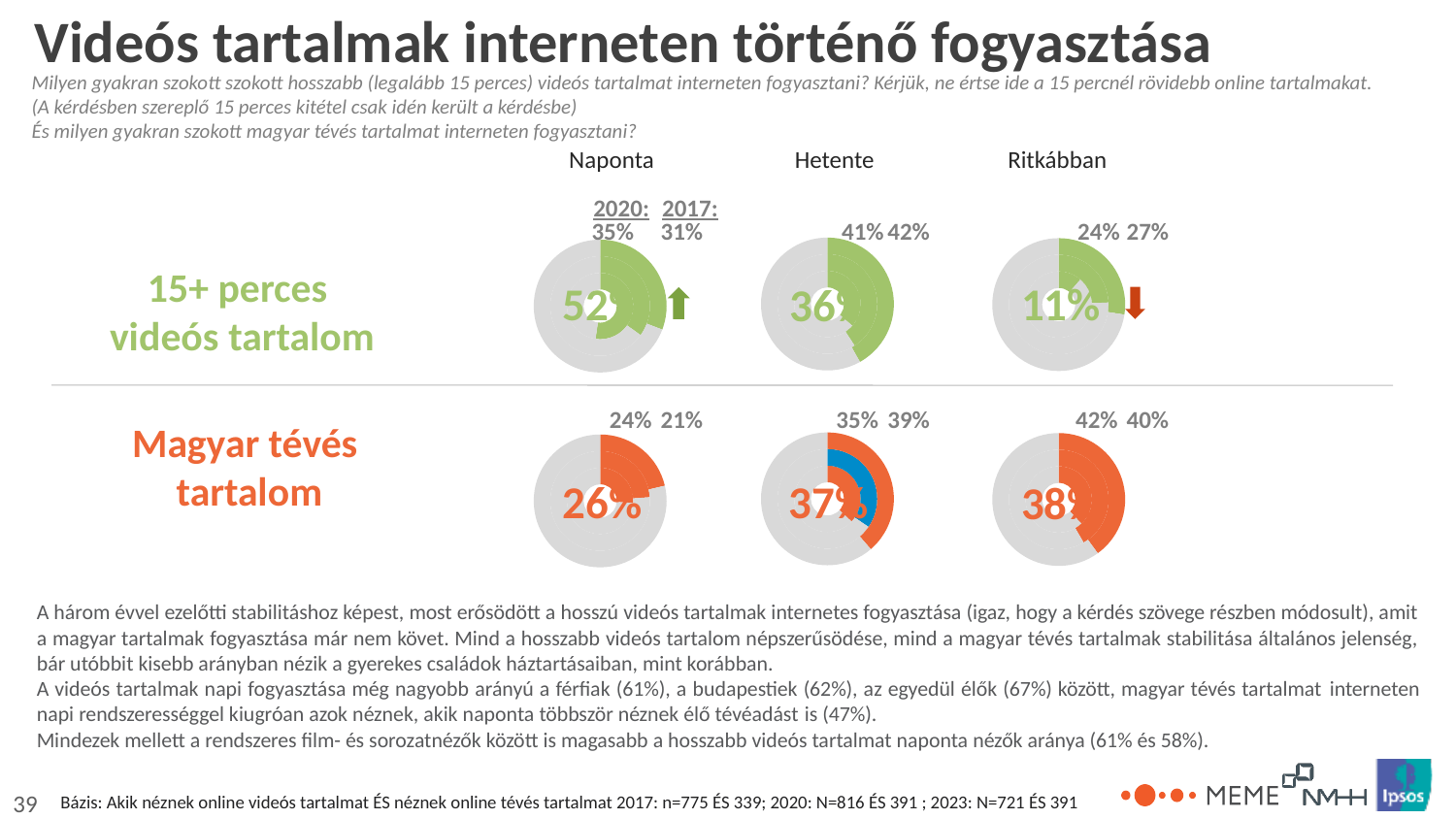
In the '15+ perces videós tartalom' row, what is the value shown in the centre of the 'Naponta' donut? 52% In the '15+ perces videós tartalom' row, what is the 2017 value printed above the 'Ritkábban' donut? 27% Which is larger: the centre value of the 'Naponta' donut in the '15+ perces videós tartalom' row or the centre value of the 'Naponta' donut in the 'Magyar tévés tartalom' row? 15+ perces videós tartalom (52%) In the 'Magyar tévés tartalom' row, which column has the lowest centre value? Naponta How many donut charts are shown on the slide? 6 In the '15+ perces videós tartalom' row, which column has the lowest centre value? Ritkábban In the '15+ perces videós tartalom' row, what is the 2020 value printed above the 'Naponta' donut? 35% In the 'Magyar tévés tartalom' row, what is the 2020 value printed above the 'Ritkábban' donut? 42% In the 'Magyar tévés tartalom' row, what is the value shown in the centre of the 'Hetente' donut? 37% In the '15+ perces videós tartalom' row, what is the difference between the 2020 and 2017 values above the 'Naponta' donut? 4 percentage points What kind of chart is used for each of the six figures on the slide? pie chart (donut) In the '15+ perces videós tartalom' row, which column (Naponta, Hetente or Ritkábban) has the highest centre value? Naponta